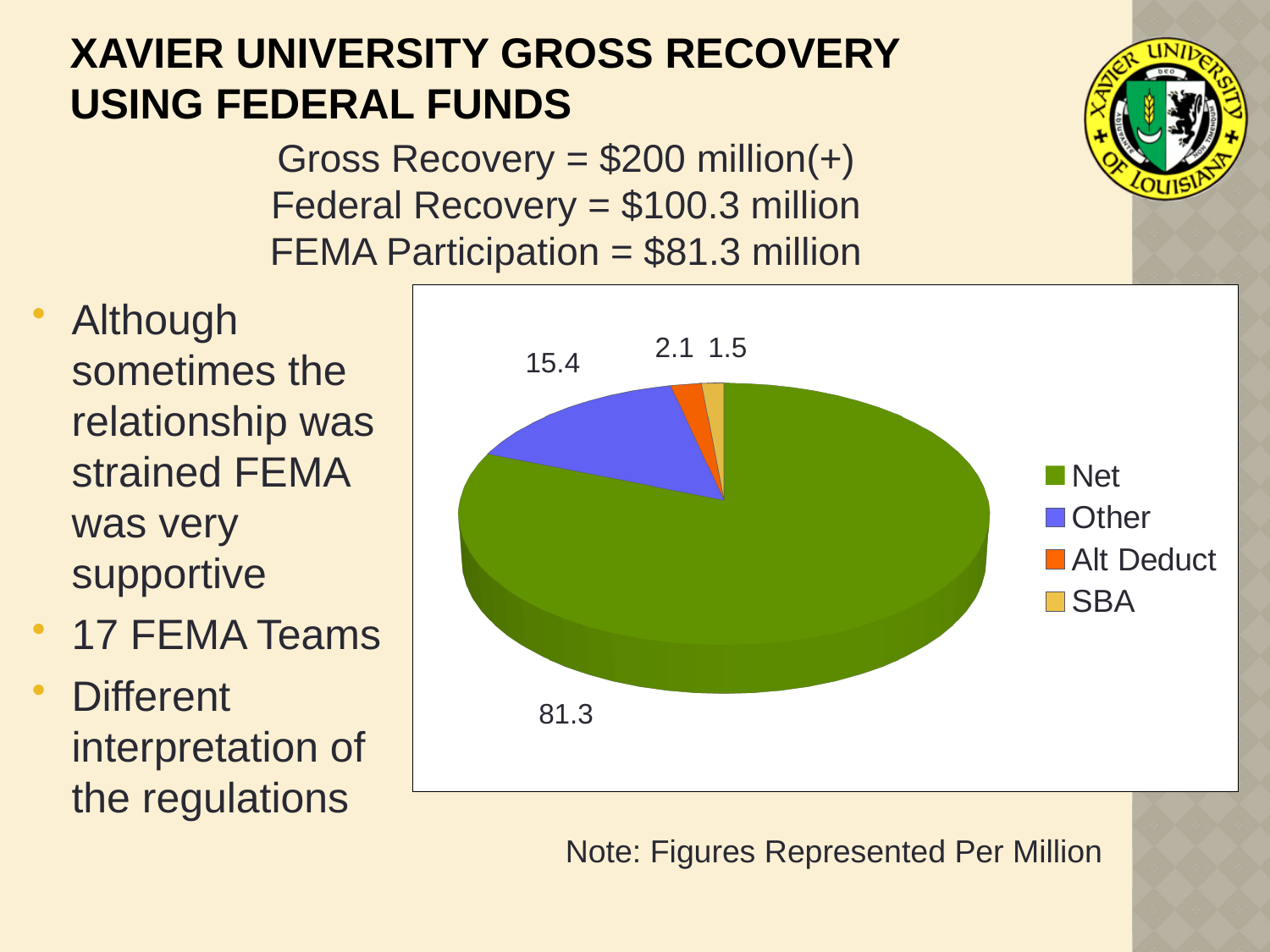
What value is shown for the Other slice of the pie chart? 15.4 What type of chart is shown on the slide? Pie chart Which category has the largest slice in the pie chart? Net What value is shown for the Alt Deduct slice of the pie chart? 2.1 What colour is the Net slice in the pie chart? Green What is the difference between the Alt Deduct value and the SBA value in the pie chart? 0.6 How many categories does the pie chart show? 4 Which category has the smallest slice in the pie chart? SBA What value is shown for the SBA slice of the pie chart? 1.5 What is the difference between the Net value and the Other value in the pie chart? 65.9 What value is shown for the Net slice of the pie chart? 81.3 Which is larger in the pie chart, Other or Alt Deduct? Other